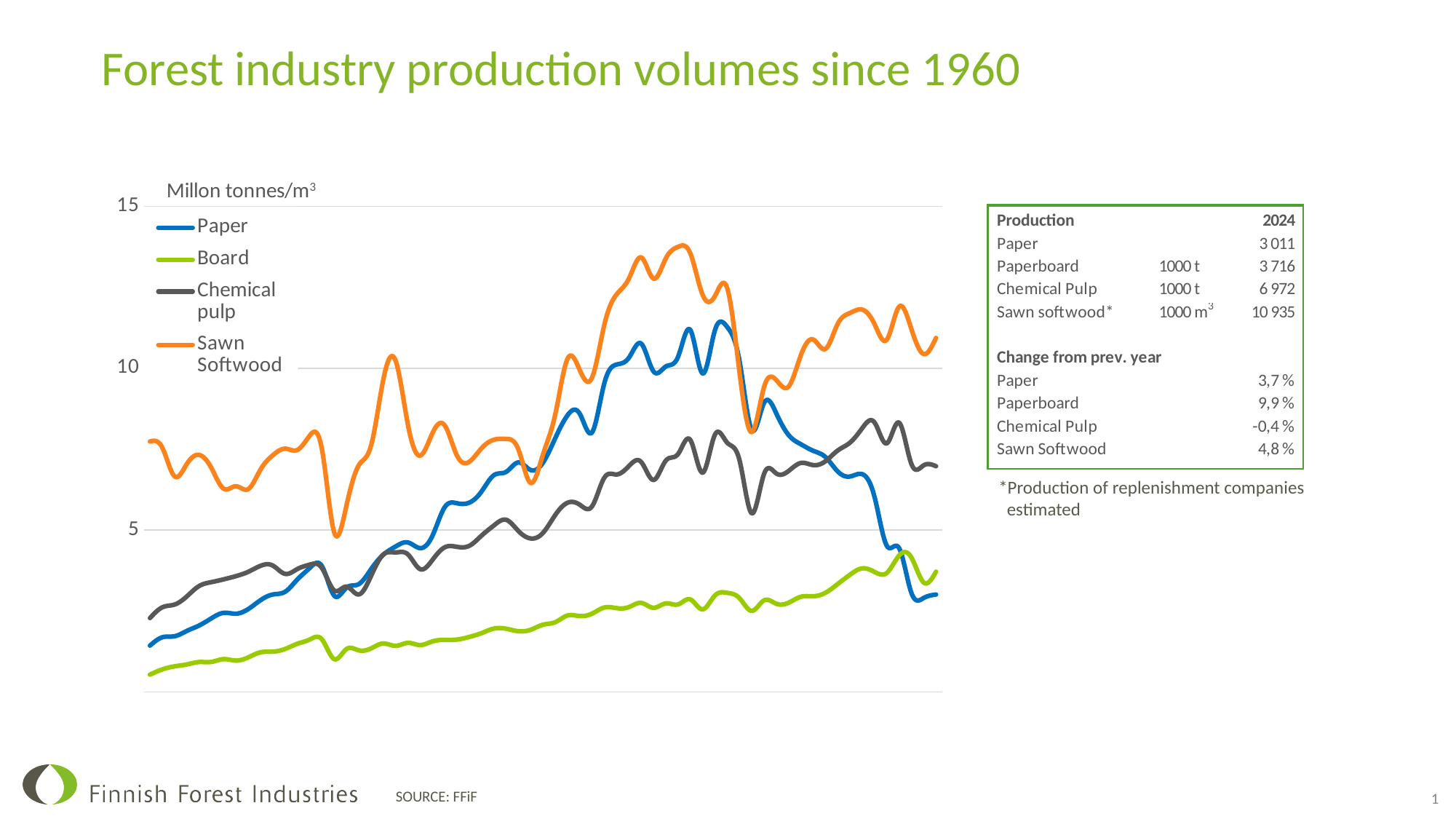
At the right end of the chart, which is higher, Sawn Softwood or Chemical pulp? Sawn Softwood Is the value of the Board line at the right end of the chart greater or less than 5? less What kind of chart is shown on the slide? line chart How many series does the chart legend list? 4 Is the highest value reached by the Sawn Softwood line greater or less than 10? greater Is the value of the Chemical pulp line at the right end of the chart greater or less than 5? greater Does the Paper line rise or fall over the final portion of the chart? fall Does the Board line generally rise or fall from left to right across the chart? rise Which series reaches the highest value anywhere on the chart? Sawn Softwood What is the title of the slide's chart? Forest industry production volumes since 1960 What colour is the Sawn Softwood line in the chart? orange Which series has the lowest values at the start of the chart? Board